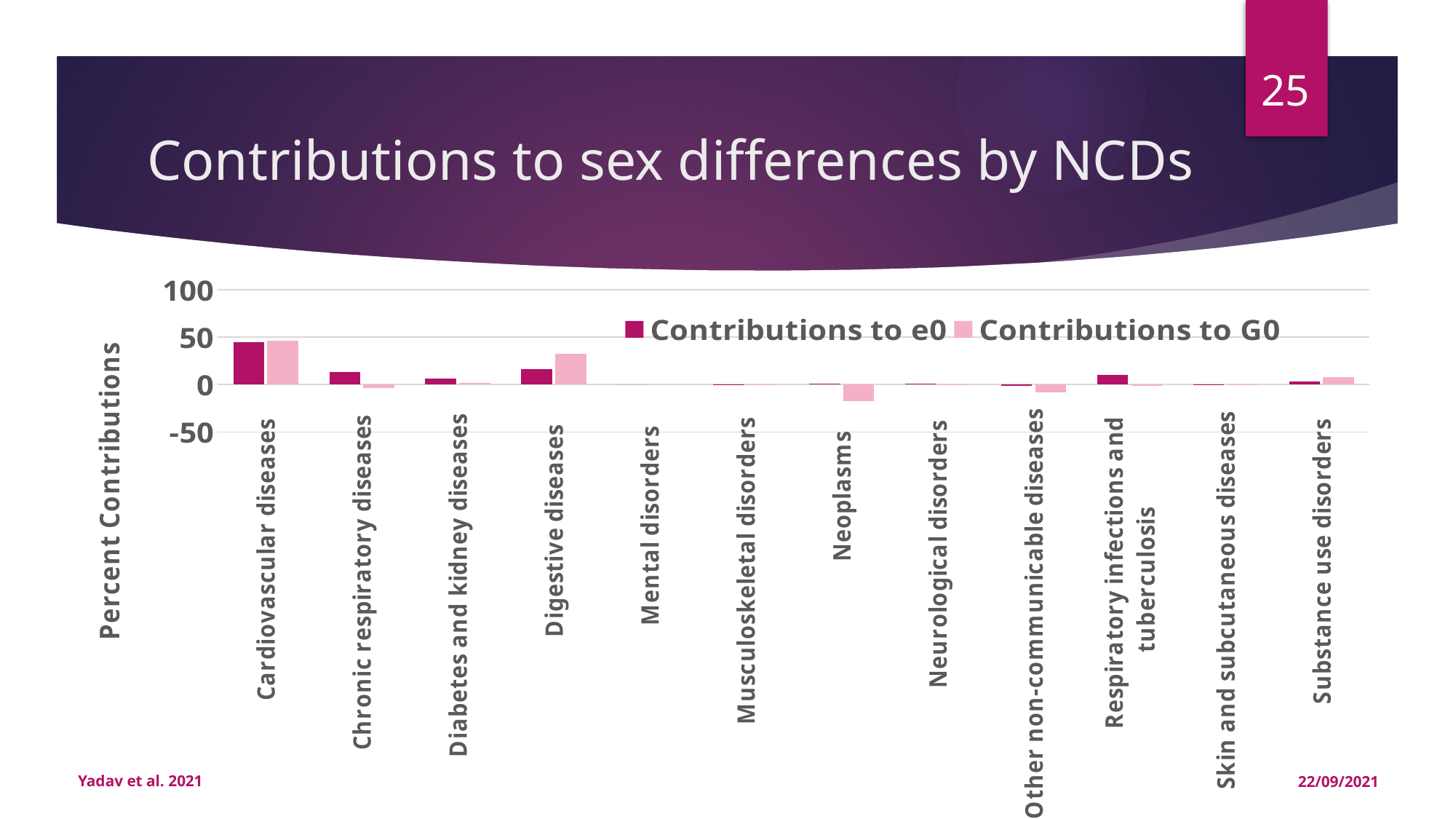
Which category has the lowest value for Contributions to G0? Neoplasms Is the value for Contributions to G0 for Digestive diseases greater or less than 0? greater Which category has the highest value for Contributions to G0? Cardiovascular diseases How many series does the legend list? 2 For Digestive diseases, which is larger: Contributions to e0 or Contributions to G0? Contributions to G0 What kind of chart is shown on the slide? Bar chart Is the value for Contributions to G0 for Neoplasms greater or less than 0? less Which category has the highest value for Contributions to e0? Cardiovascular diseases Is the value for Contributions to e0 for Cardiovascular diseases greater or less than 50? less For Contributions to e0, which is larger: Cardiovascular diseases or Chronic respiratory diseases? Cardiovascular diseases How many disease categories are shown on the x axis? 12 What is the label on the y axis of the chart? Percent Contributions